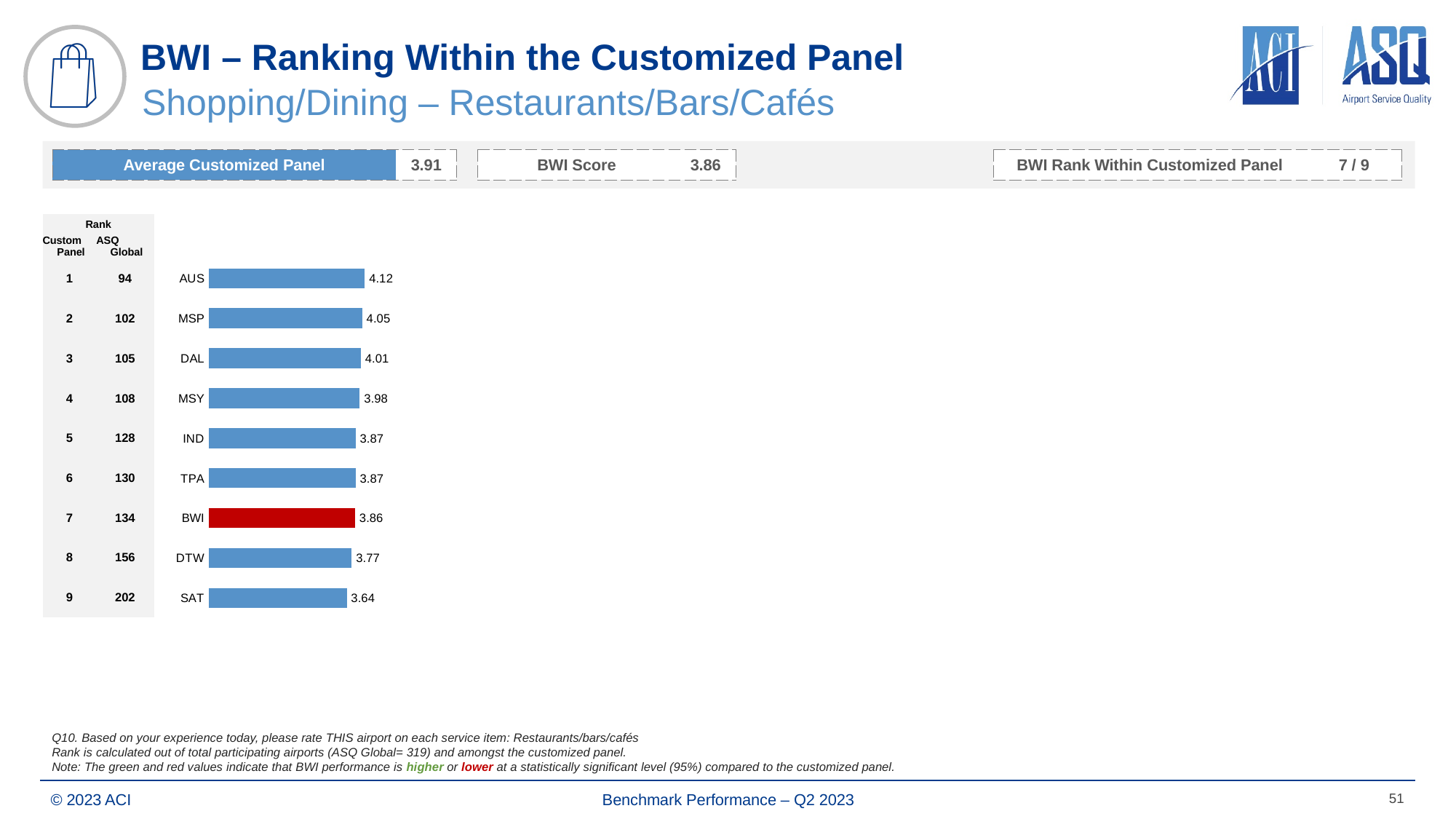
What is the value for DTW? 3.77 How many airports are shown in the chart? 9 What is the value for AUS? 4.12 Which has a larger value, DAL or DTW? DAL What is the value for SAT? 3.64 What is the difference between the values for MSP and BWI? 0.19 What is the value for BWI? 3.86 What is the difference between the values for AUS and SAT? 0.48 What kind of chart is shown? Bar chart Which airport has the highest value? AUS Which bar is coloured red? BWI Which airport has the lowest value? SAT